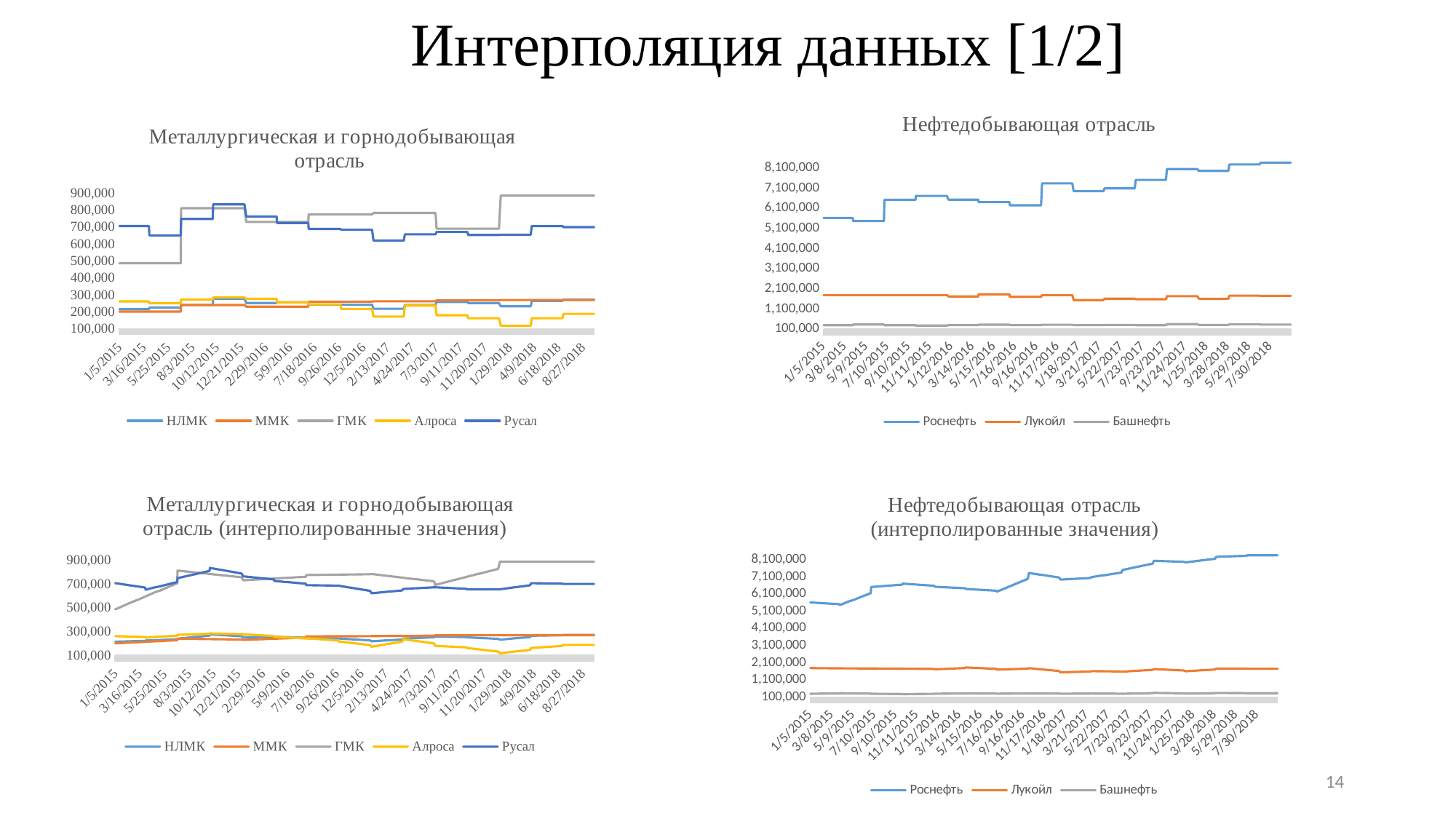
In the bottom-left chart "Металлургическая и горнодобывающая отрасль (интерполированные значения)", is the value for Алроса at 1/29/2018 greater or less than 300,000? less In the top-right chart "Нефтедобывающая отрасль", which series has the highest values? Роснефть In the top-left chart "Металлургическая и горнодобывающая отрасль", which is higher at 8/27/2018: ГМК or Алроса? ГМК What kind of chart is the top-left chart titled "Металлургическая и горнодобывающая отрасль"? Line chart How many series does the legend of the top-left chart "Металлургическая и горнодобывающая отрасль" list? 5 In the top-right chart "Нефтедобывающая отрасль", does the Роснефть line generally rise or fall from 1/5/2015 to 7/30/2018? Rise In the top-right chart "Нефтедобывающая отрасль", is the value for Роснефть at 1/5/2015 greater or less than 6,100,000? less What is the title of the bottom-right chart? Нефтедобывающая отрасль (интерполированные значения) In the top-right chart "Нефтедобывающая отрасль", which series has the lowest values? Башнефть In the top-right chart "Нефтедобывающая отрасль", is the value for Лукойл at 1/5/2015 greater or less than 2,100,000? less How many series does the legend of the top-right chart "Нефтедобывающая отрасль" list? 3